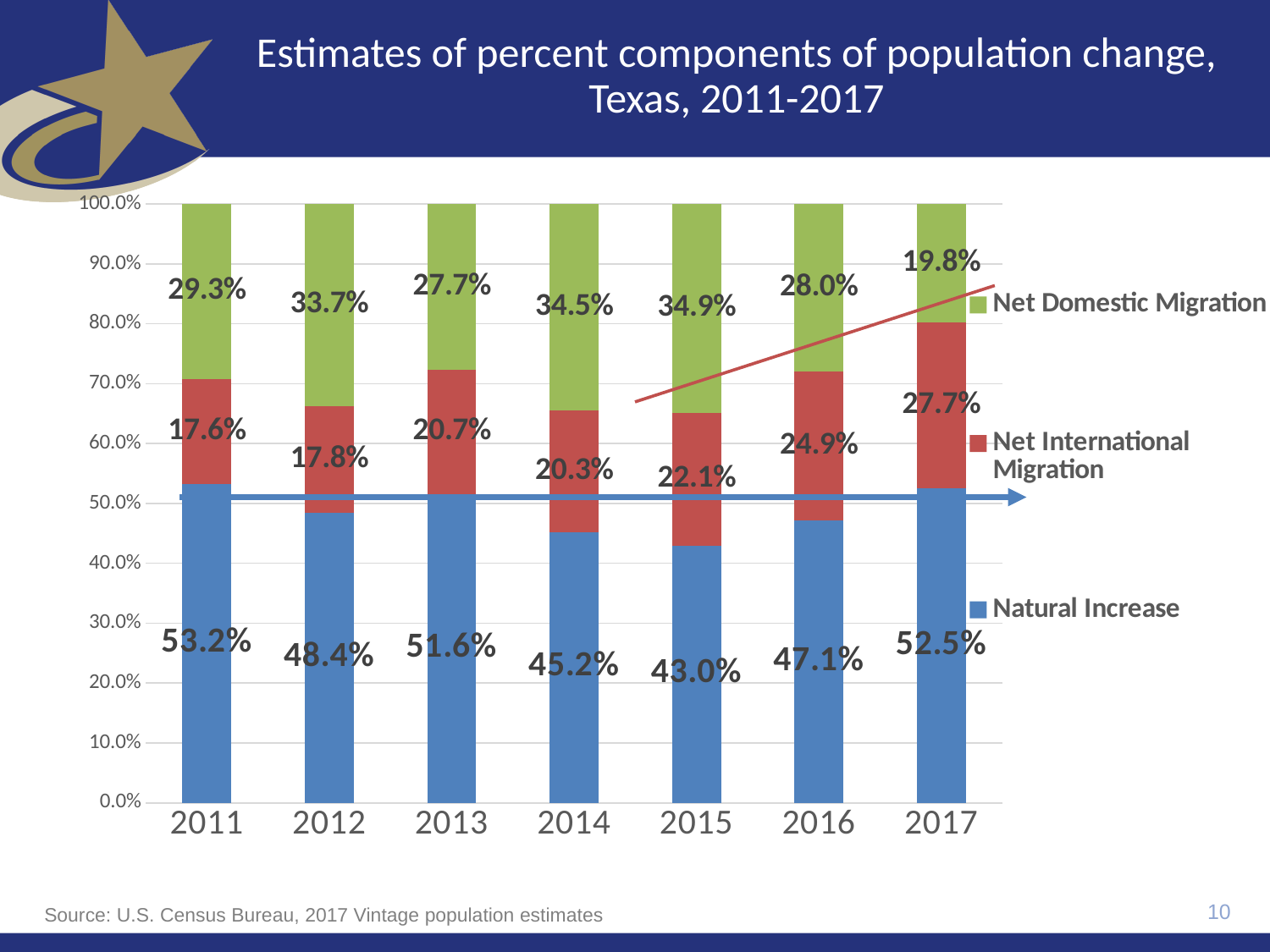
What is the Net Domestic Migration value for 2012? 33.7% What is the Natural Increase value for 2015? 43.0% Which year has the highest Natural Increase share? 2011 What is the difference between the Net Domestic Migration values for 2015 and 2017? 15.1% What kind of chart is shown on the slide? Stacked bar chart Which is larger, the Net International Migration value for 2016 or for 2013? 2016 How many years are shown on the x axis? 7 What is the Net International Migration value for 2017? 27.7% Does the Net International Migration share rise or fall from 2011 to 2017? Rise What is the title of the chart? Estimates of percent components of population change, Texas, 2011-2017 Which year has the lowest Net Domestic Migration share? 2017 How many series does the legend list? 3